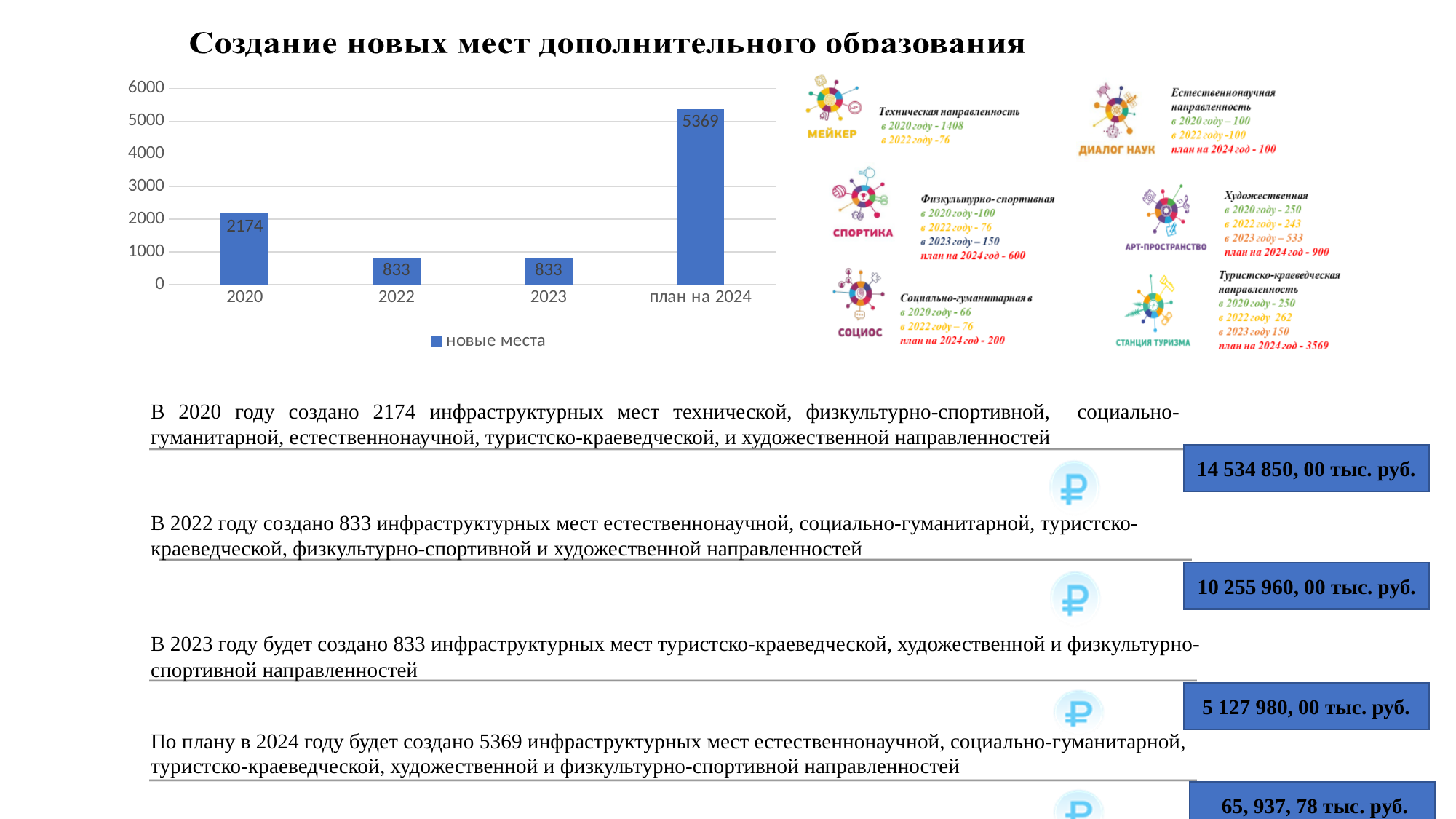
What is the value for 2023 in the bar chart? 833 What is the value for 2020 in the bar chart? 2174 What is the value for 'план на 2024' in the bar chart? 5369 What kind of chart is shown on the slide? bar chart What is the difference between the value for 2020 and the value for 2022? 1341 What is the difference between the value for 'план на 2024' and the value for 2020? 3195 Is the value for 'план на 2024' greater or less than 5000? greater What is the name of the series shown in the chart legend? новые места Which is larger, the value for 2020 or the value for 2022? 2020 How many categories are shown on the x axis of the bar chart? 4 Which category has the highest value in the bar chart? план на 2024 Is the value for 2022 greater or less than 1000? less